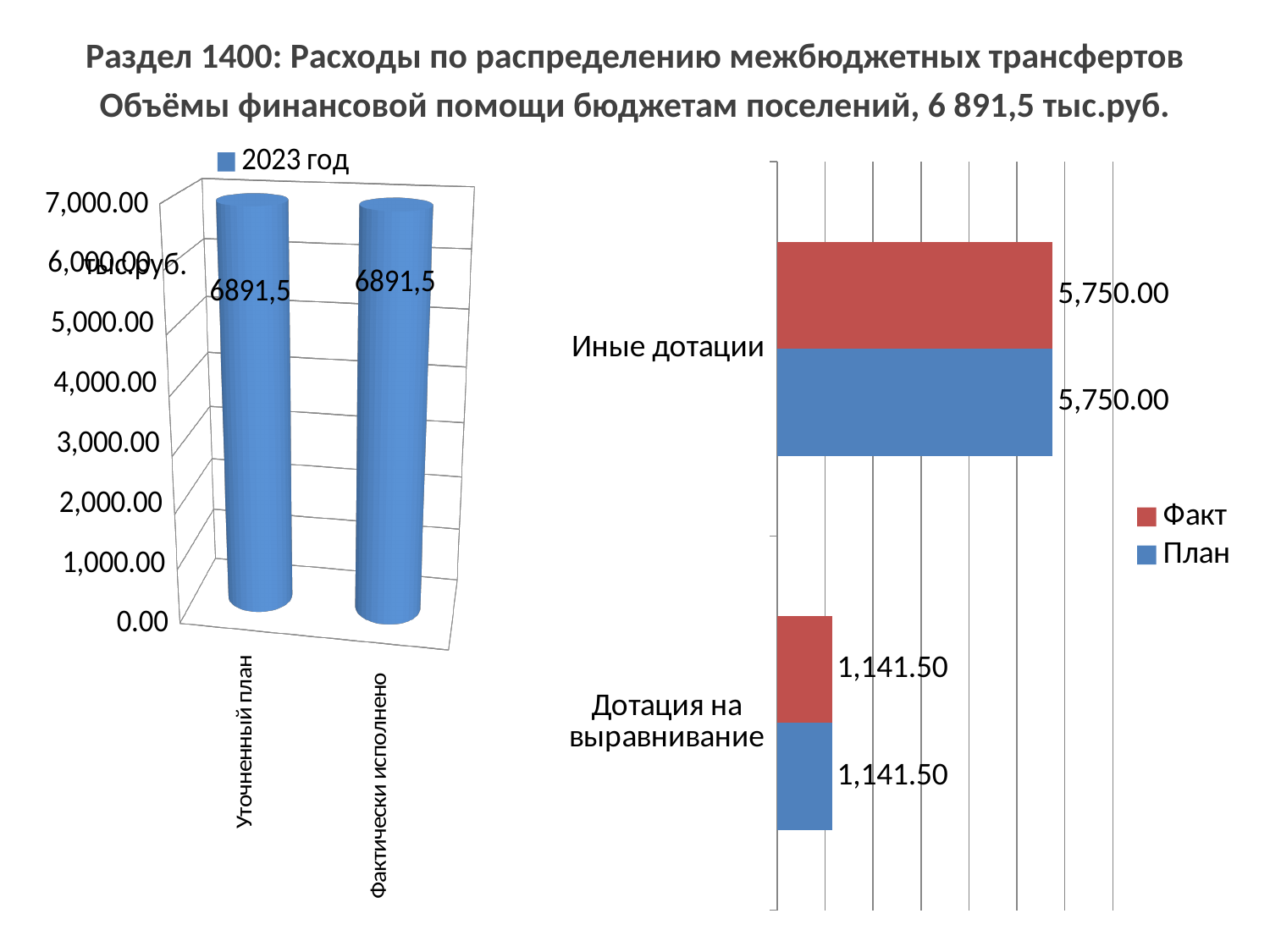
On the left chart, how many bars are plotted? 2 On the right chart, what is the difference between the Факт values for Иные дотации and Дотация на выравнивание? 4,608.50 On the left chart, what series does the legend list? 2023 год On the left chart, what is the value for Уточненный план? 6891,5 On the right chart, what is the План value for Иные дотации? 5,750.00 On the right chart, what kind of chart is shown? Bar chart On the left chart, what is the value for Фактически исполнено? 6891,5 On the left chart, what is the difference between Уточненный план and Фактически исполнено? 0 On the right chart, which colour represents Факт? Red On the right chart, what is the Факт value for Дотация на выравнивание? 1,141.50 On the right chart, how many series does the legend list? 2 On the right chart, which category has the higher План value? Иные дотации